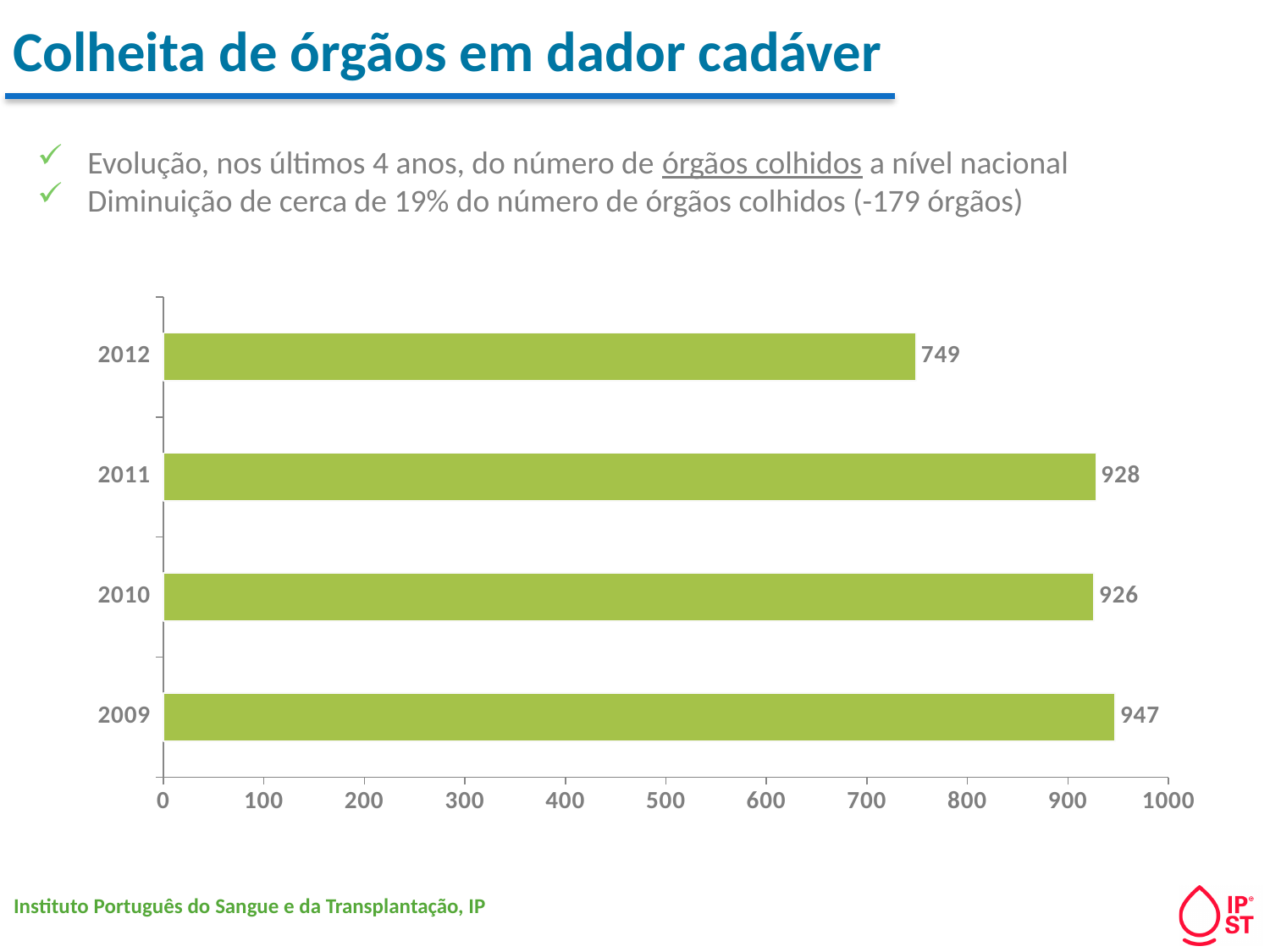
Which year has the lowest value? 2012 How many years are shown in the chart? 4 What is the value for 2009? 947 What kind of chart is shown on the slide? bar chart Is the value for 2012 greater or less than 800? less What is the value for 2012? 749 What is the value for 2011? 928 Which year has the highest value? 2009 What is the value for 2010? 926 What colour are the bars in the chart? green Which is larger, the value for 2009 or the value for 2012? 2009 What is the difference between the values for 2011 and 2012? 179